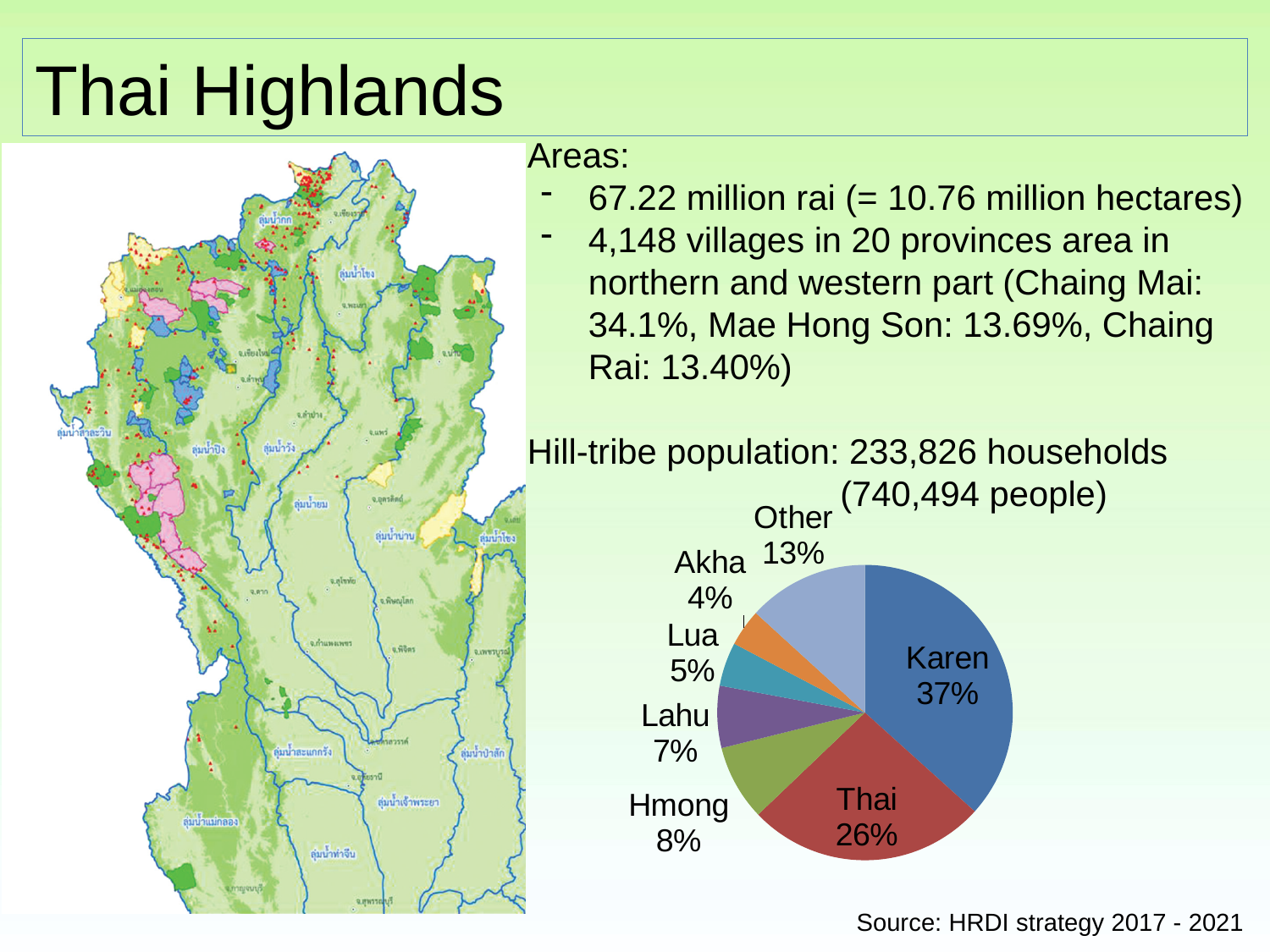
What is the difference in percentage points between the Karen and Thai shares? 11 What share of the hill-tribe population is Lahu? 7% What kind of chart is shown on the slide? pie chart What share of the hill-tribe population is Karen? 37% What share of the hill-tribe population is Thai? 26% How many slices does the pie chart have? 7 What share of the hill-tribe population is labelled Other? 13% Which group has the largest slice of the pie chart? Karen Which is larger, the Lua share or the Lahu share? Lahu What share of the hill-tribe population is Hmong? 8% Which group has the smallest slice of the pie chart? Akha What share of the hill-tribe population is Akha? 4%